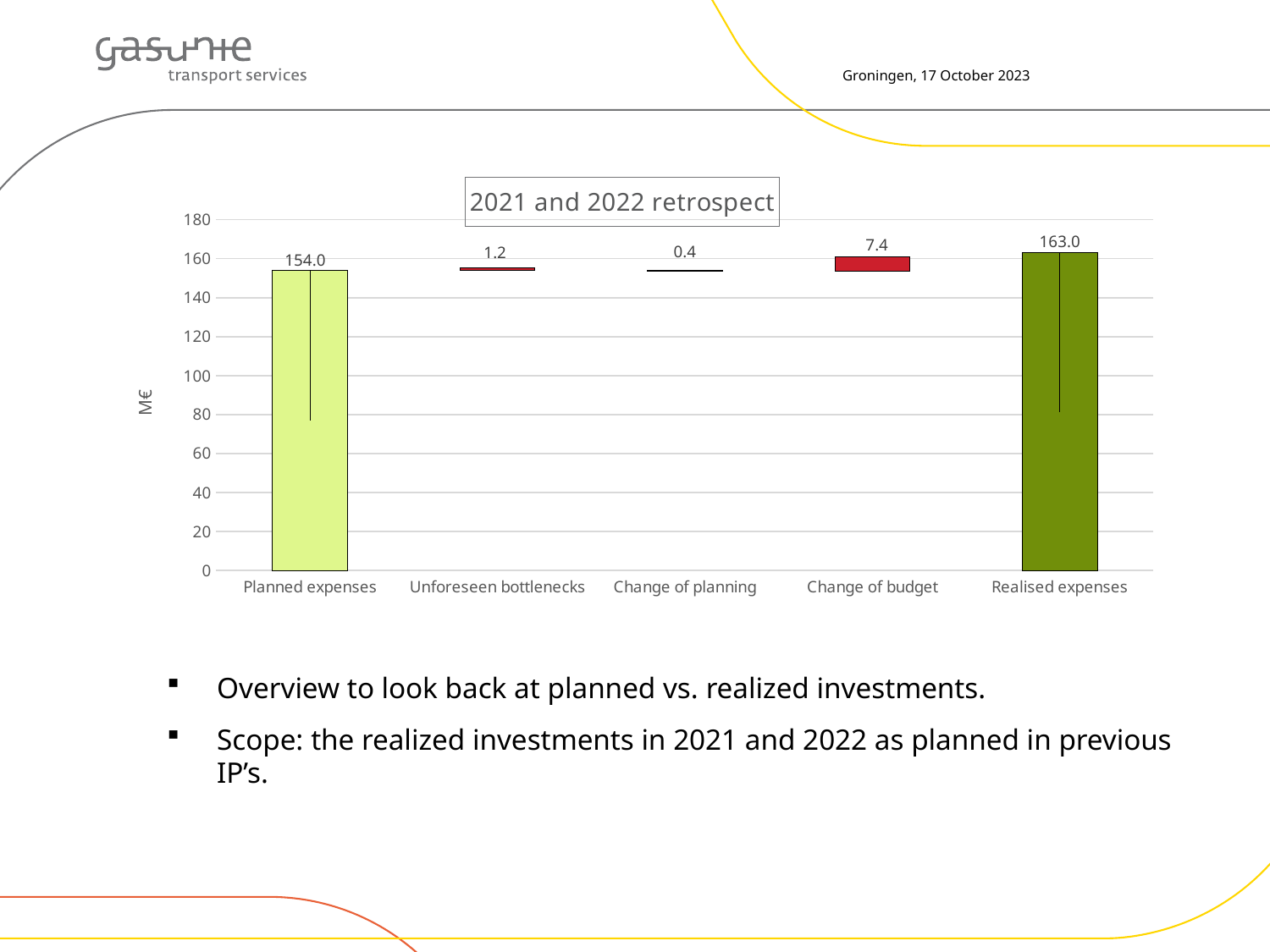
What is the title of the chart? 2021 and 2022 retrospect How many categories are shown on the x axis? 5 What is the value for Change of budget? 7.4 Which is larger, Change of budget or Unforeseen bottlenecks? Change of budget What is the difference between Realised expenses and Planned expenses? 9.0 What kind of chart is this? Bar chart What is the value for Change of planning? 0.4 What is the value for Planned expenses? 154.0 Which category has the highest value? Realised expenses What is the value for Realised expenses? 163.0 What is the value for Unforeseen bottlenecks? 1.2 Which category has the lowest value? Change of planning